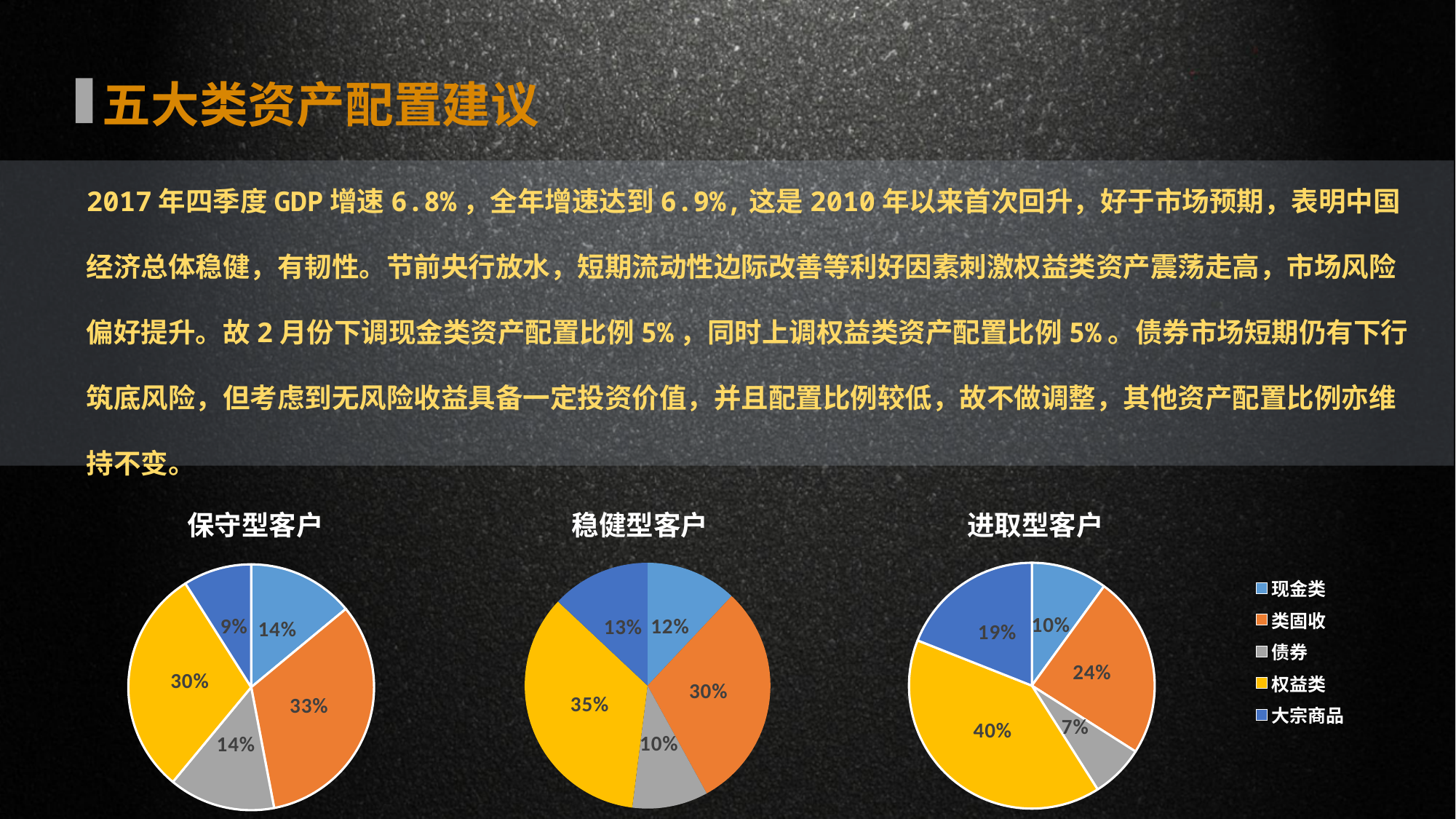
In the 进取型客户 pie chart, which category has the largest share? 权益类 In the 进取型客户 pie chart, what share does 大宗商品 have? 19% In the 稳健型客户 pie chart, which is larger: 现金类 or 大宗商品? 大宗商品 Which colour represents 权益类 in the legend? Yellow How many slices does the 保守型客户 pie chart have? 5 In the 进取型客户 pie chart, what is the difference between the shares of 权益类 and 类固收? 16% How many entries does the legend list? 5 What kind of chart is used for 稳健型客户? Pie chart In the 稳健型客户 pie chart, what share does 权益类 have? 35% In the 稳健型客户 pie chart, which category has the smallest share? 债券 In the 保守型客户 pie chart, which category has the smallest share? 大宗商品 In the 保守型客户 pie chart, what share does 类固收 have? 33%